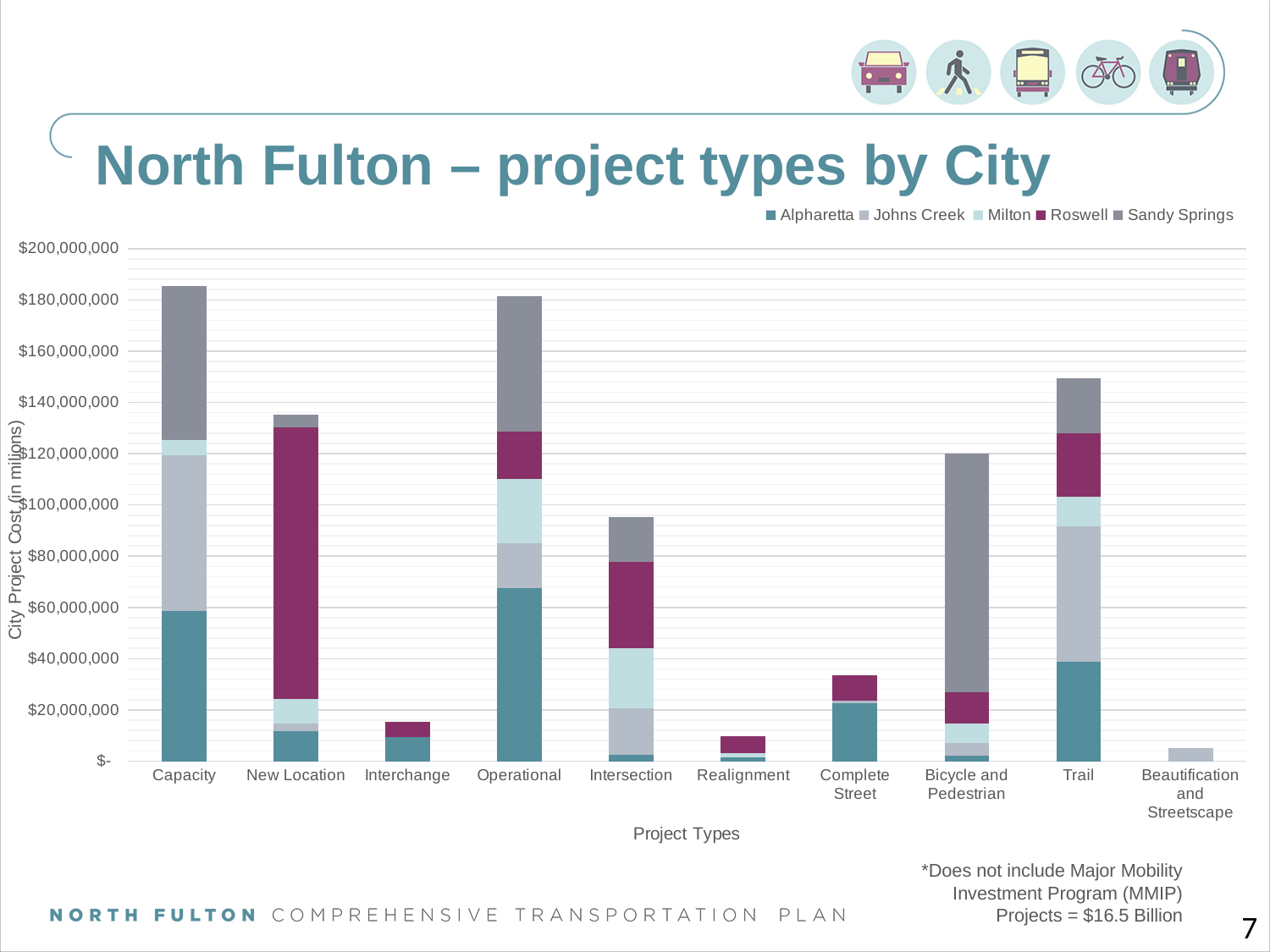
Is the total city project cost for Intersection greater or less than $100,000,000? less How many project types are shown along the x axis? 10 How many cities does the legend list? 5 What is the label of the y axis? City Project Cost (in millions) What is the title of the chart? North Fulton – project types by City Which project type has the lowest total city project cost? Beautification and Streetscape Is the total city project cost for Trail greater or less than $140,000,000? greater Which has a larger total city project cost, New Location or Intersection? New Location Which has a larger total city project cost, Trail or Bicycle and Pedestrian? Trail Is the total city project cost for Interchange greater or less than $20,000,000? less What kind of chart is shown on the slide? Stacked bar chart